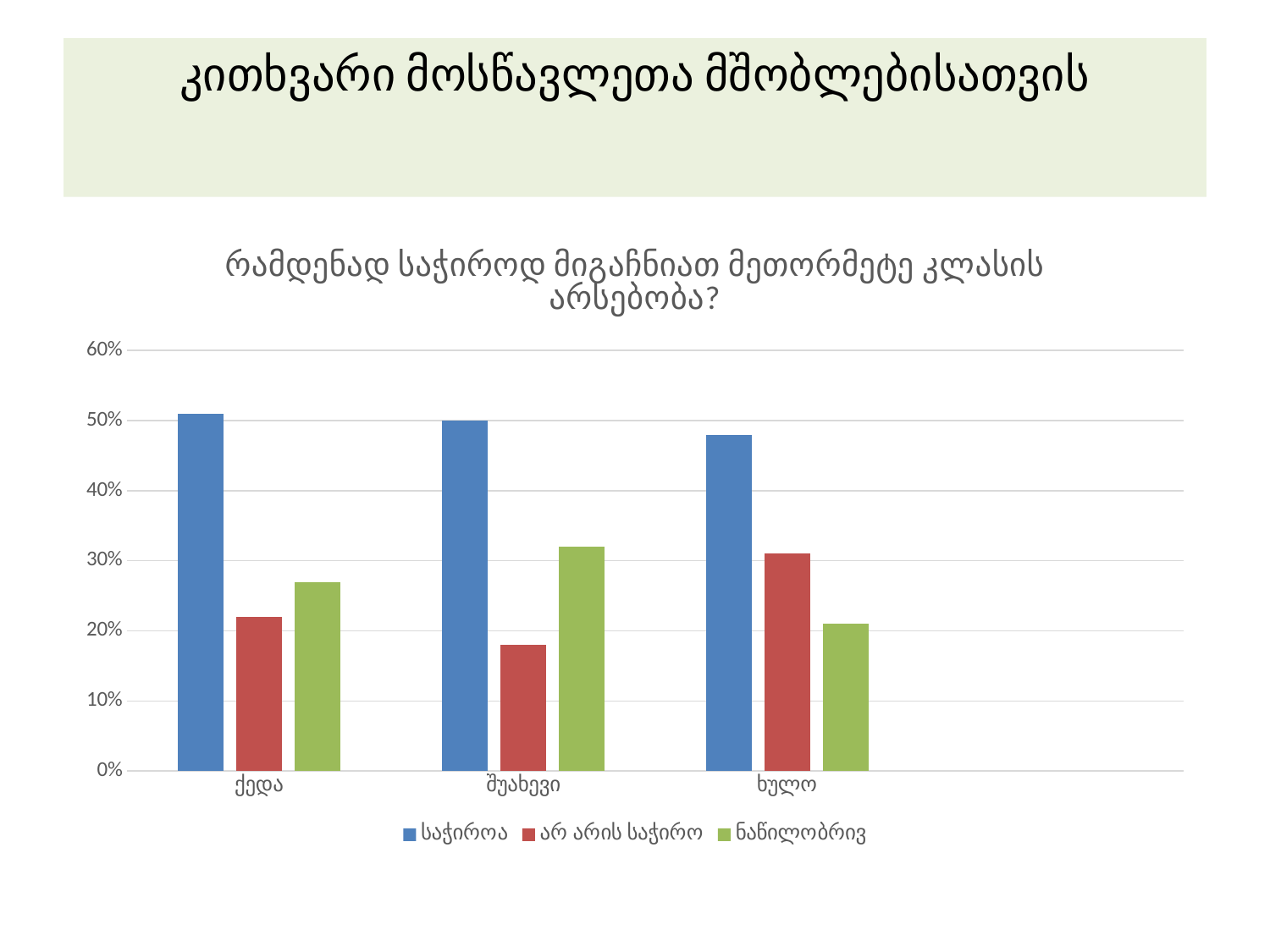
Is the value of საჭიროა for ქედა greater or less than 40%? greater What kind of chart is shown on the slide? bar chart Which series has the lowest value for შუახევი? არ არის საჭირო Which series has the lowest value for ხულო? ნაწილობრივ How many series does the chart legend list? 3 For შუახევი, which is larger: არ არის საჭირო or ნაწილობრივ? ნაწილობრივ Is the value of ნაწილობრივ for ქედა greater or less than 30%? less How many categories are shown on the x axis of the chart? 3 Which series has the highest value for ქედა? საჭიროა What colour are the bars for the series ნაწილობრივ? green Is the value of არ არის საჭირო for ხულო greater or less than 20%? greater For ხულო, which is larger: არ არის საჭირო or ნაწილობრივ? არ არის საჭირო